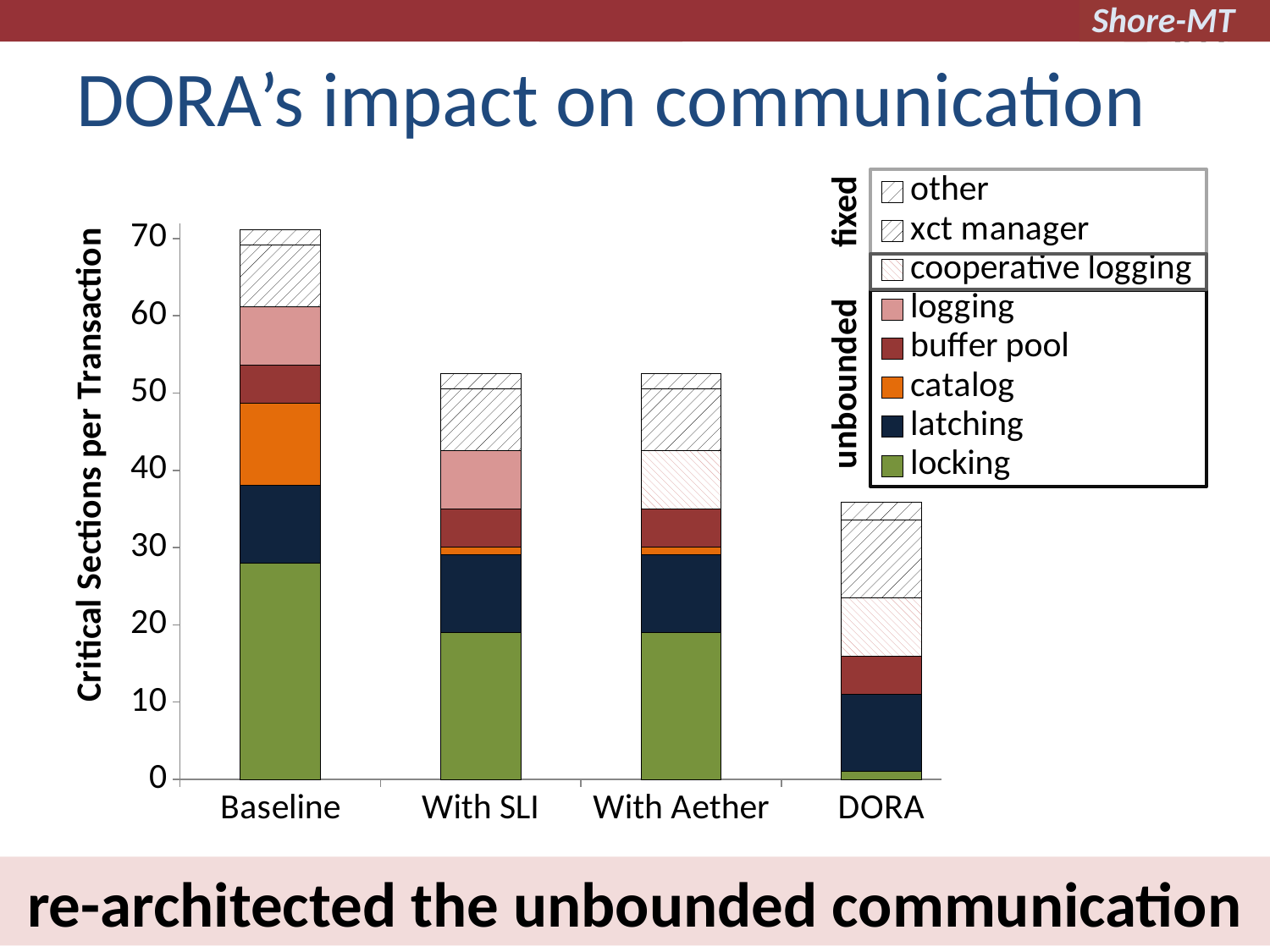
Which category has the lowest total critical sections per transaction? DORA How many series does the legend list? 8 How many categories are shown on the x axis? 4 Which category has the highest total critical sections per transaction? Baseline What is the title of the y axis? Critical Sections per Transaction Is the locking value for DORA greater or less than 10? less Do the total bar heights generally rise or fall from Baseline to DORA along the x axis? fall What kind of chart is shown on the slide? stacked bar chart Is the total value for With SLI greater or less than 50? greater Which has a larger total, Baseline or DORA? Baseline Is the total value for DORA greater or less than 40? less